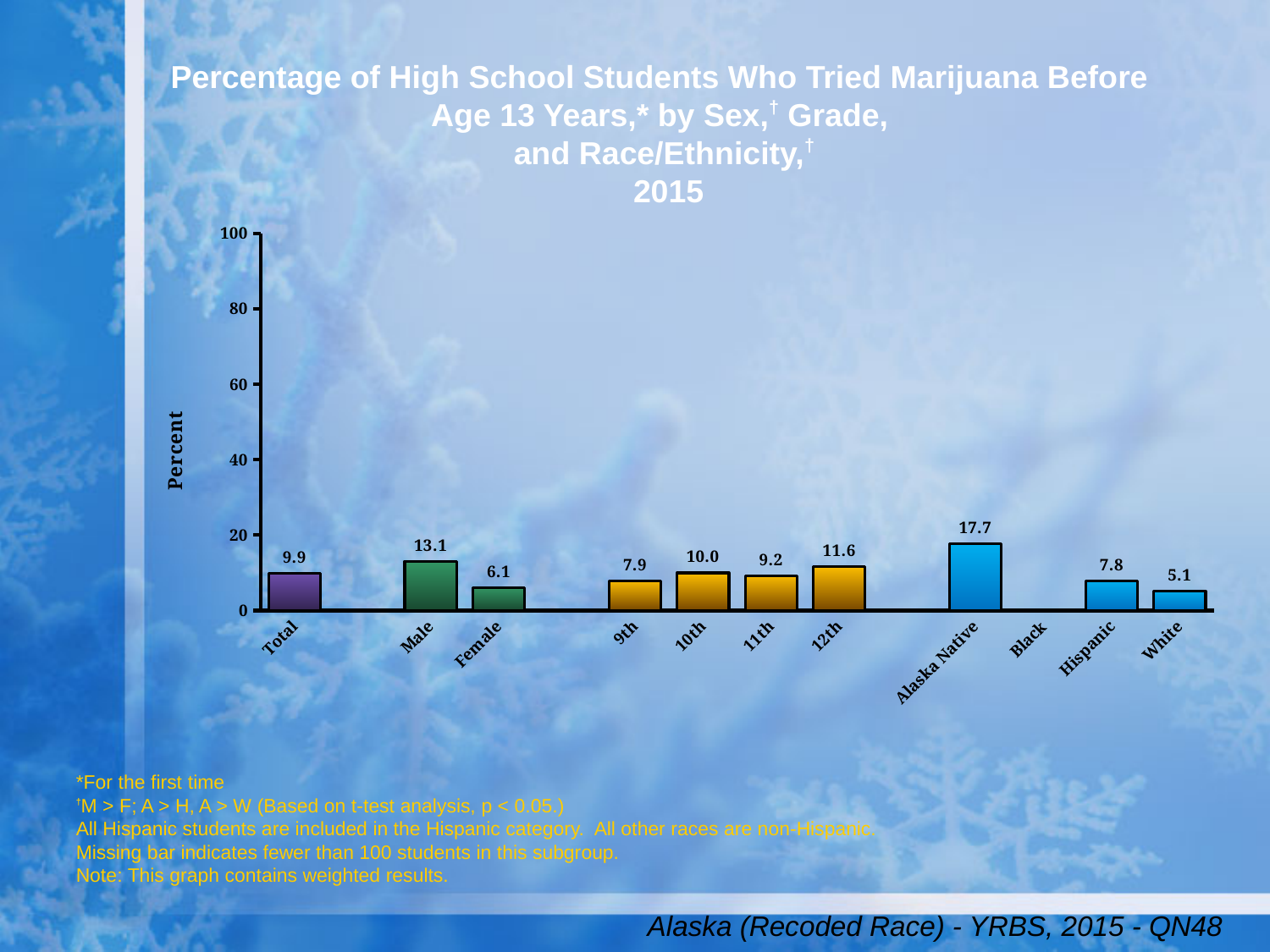
Which is larger, the value for Hispanic or the value for White? Hispanic How many categories are labeled on the x axis? 11 What is the value for Alaska Native? 17.7 What is the value for 12th grade? 11.6 Which category with a plotted bar has the lowest value? White Which category has the highest value? Alaska Native What is the value for Male? 13.1 Is the value for Alaska Native greater or less than 20? less Which category has no bar plotted? Black What is the value for Total? 9.9 What is the difference between the values for Male and Female? 7.0 What kind of chart is shown? bar chart